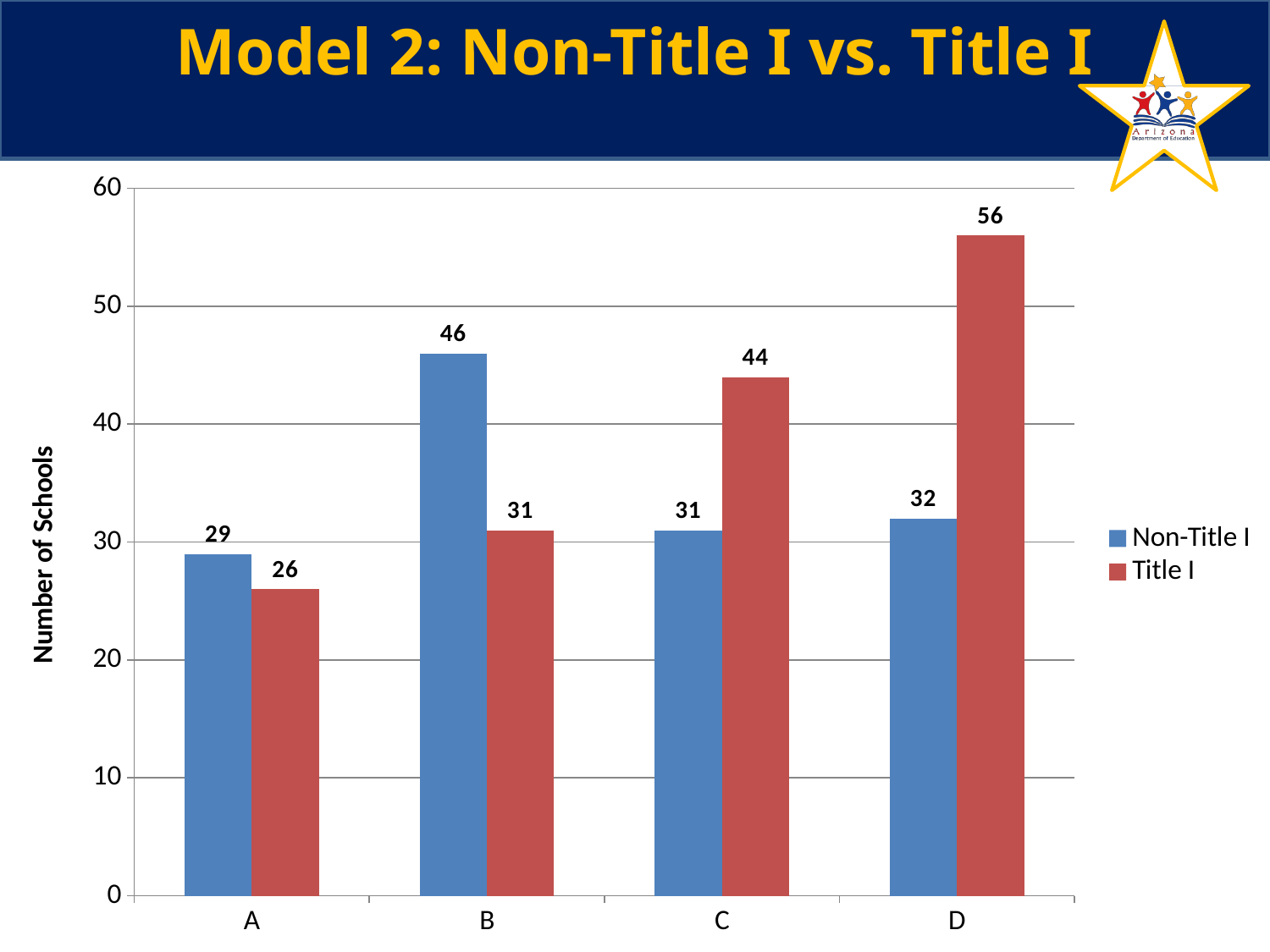
What is the Non-Title I value for category B? 46 Which category has the lowest Non-Title I value? A Which category has the highest Title I value? D What is the difference between the Title I and Non-Title I values for category D? 24 How many categories are shown on the x axis? 4 Do the Title I values rise or fall from category B to category D? Rise What is the label of the y axis? Number of Schools Which is larger for category B, the Non-Title I value or the Title I value? Non-Title I What is the Title I value for category D? 56 What is the Title I value for category A? 26 How many series does the legend list? 2 What kind of chart is shown on the slide? Bar chart